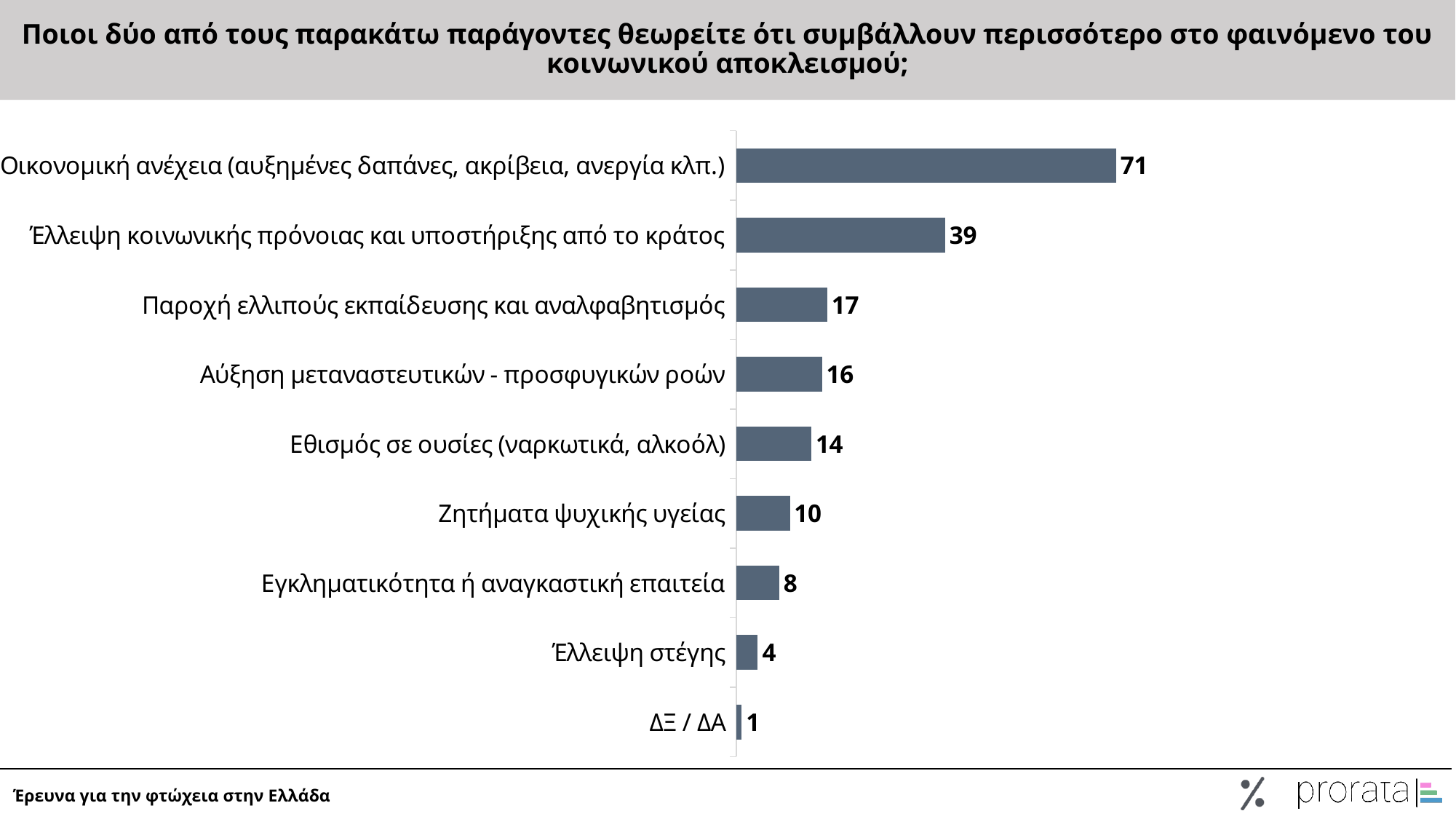
What kind of chart is shown on the slide? Bar chart What is the difference between the values for "Οικονομική ανέχεια" and "Έλλειψη κοινωνικής πρόνοιας και υποστήριξης από το κράτος"? 32 How many categories are shown in the chart? 9 What value is shown for "Οικονομική ανέχεια (αυξημένες δαπάνες, ακρίβεια, ανεργία κλπ.)"? 71 What value is shown for "Έλλειψη κοινωνικής πρόνοιας και υποστήριξης από το κράτος"? 39 Which category has the lowest value? ΔΞ / ΔΑ What is the difference between the values for "Εθισμός σε ουσίες (ναρκωτικά, αλκοόλ)" and "Εγκληματικότητα ή αναγκαστική επαιτεία"? 6 What is the footer text at the bottom left of the slide? Έρευνα για την φτώχεια στην Ελλάδα Which has a larger value: "Παροχή ελλιπούς εκπαίδευσης και αναλφαβητισμός" or "Αύξηση μεταναστευτικών - προσφυγικών ροών"? Παροχή ελλιπούς εκπαίδευσης και αναλφαβητισμός What value is shown for "Ζητήματα ψυχικής υγείας"? 10 What value is shown for "Έλλειψη στέγης"? 4 Which category has the highest value? Οικονομική ανέχεια (αυξημένες δαπάνες, ακρίβεια, ανεργία κλπ.)